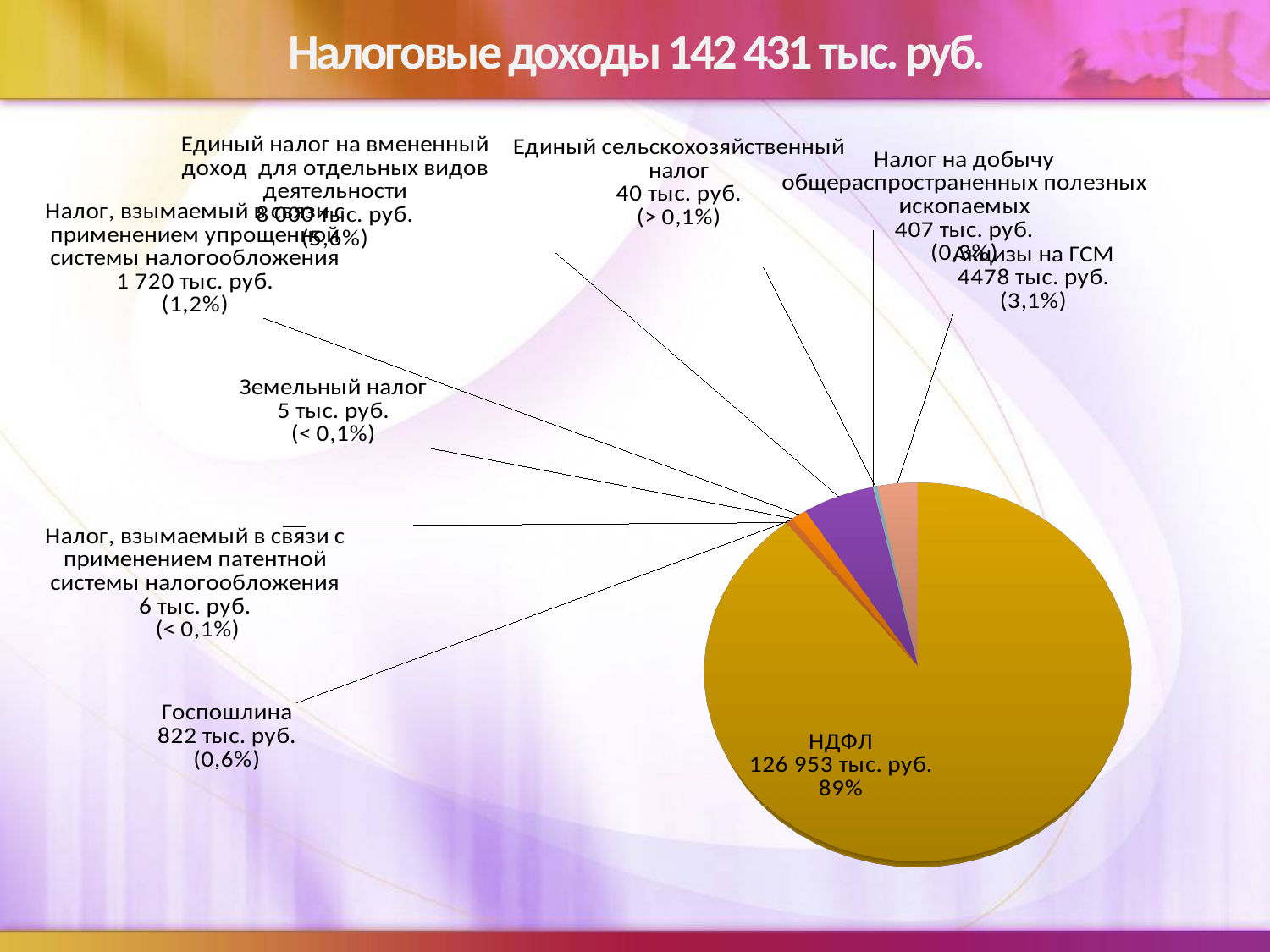
What is the value for Госпошлина? 822 тыс. руб. What share of the pie does НДФЛ take? 89% What is the difference between the values for НДФЛ and Акцизы на ГСМ? 122 475 тыс. руб. What kind of chart is shown on the slide? pie chart Which is larger, the value for Госпошлина or the value for Единый сельскохозяйственный налог? Госпошлина Which category has the smallest value? Земельный налог What is the title of the chart? Налоговые доходы 142 431 тыс. руб. Which category has the largest slice of the pie? НДФЛ What percentage share is shown for Налог, взымаемый в связи с применением упрощенной системы налогообложения? 1,2% What is the value for НДФЛ? 126 953 тыс. руб. What is the value for Налог на добычу общераспространенных полезных ископаемых? 407 тыс. руб. What is the value for Акцизы на ГСМ? 4478 тыс. руб.